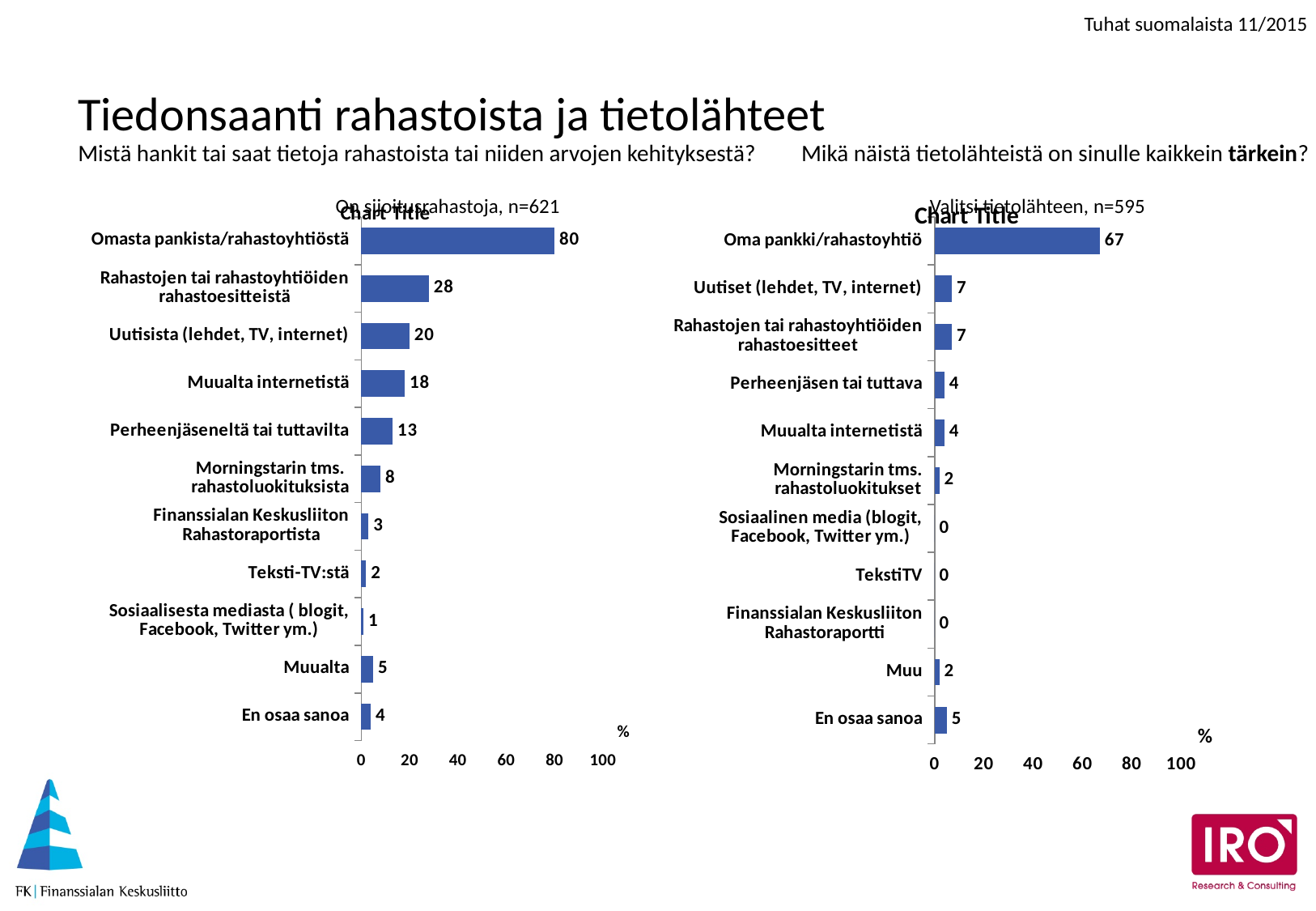
What type of chart is the left chart? Bar chart In the left chart, what is the value for Muualta internetistä? 18 In the left chart, which is larger: Perheenjäseneltä tai tuttavilta or Morningstarin tms. rahastoluokituksista? Perheenjäseneltä tai tuttavilta In the left chart, what is the value for Omasta pankista/rahastoyhtiöstä? 80 In the right chart, how many categories have a value of 0? 3 In the left chart, which category has the highest value? Omasta pankista/rahastoyhtiöstä In the right chart, what is the value for En osaa sanoa? 5 In the right chart, what is the difference between Oma pankki/rahastoyhtiö and Uutiset (lehdet, TV, internet)? 60 In the left chart, which category has the lowest value? Sosiaalisesta mediasta ( blogit, Facebook, Twitter ym.) In the right chart, what is the value for Oma pankki/rahastoyhtiö? 67 In the left chart, what is the difference between Rahastojen tai rahastoyhtiöiden rahastoesitteistä and Uutisista (lehdet, TV, internet)? 8 How many categories does the right chart show? 11